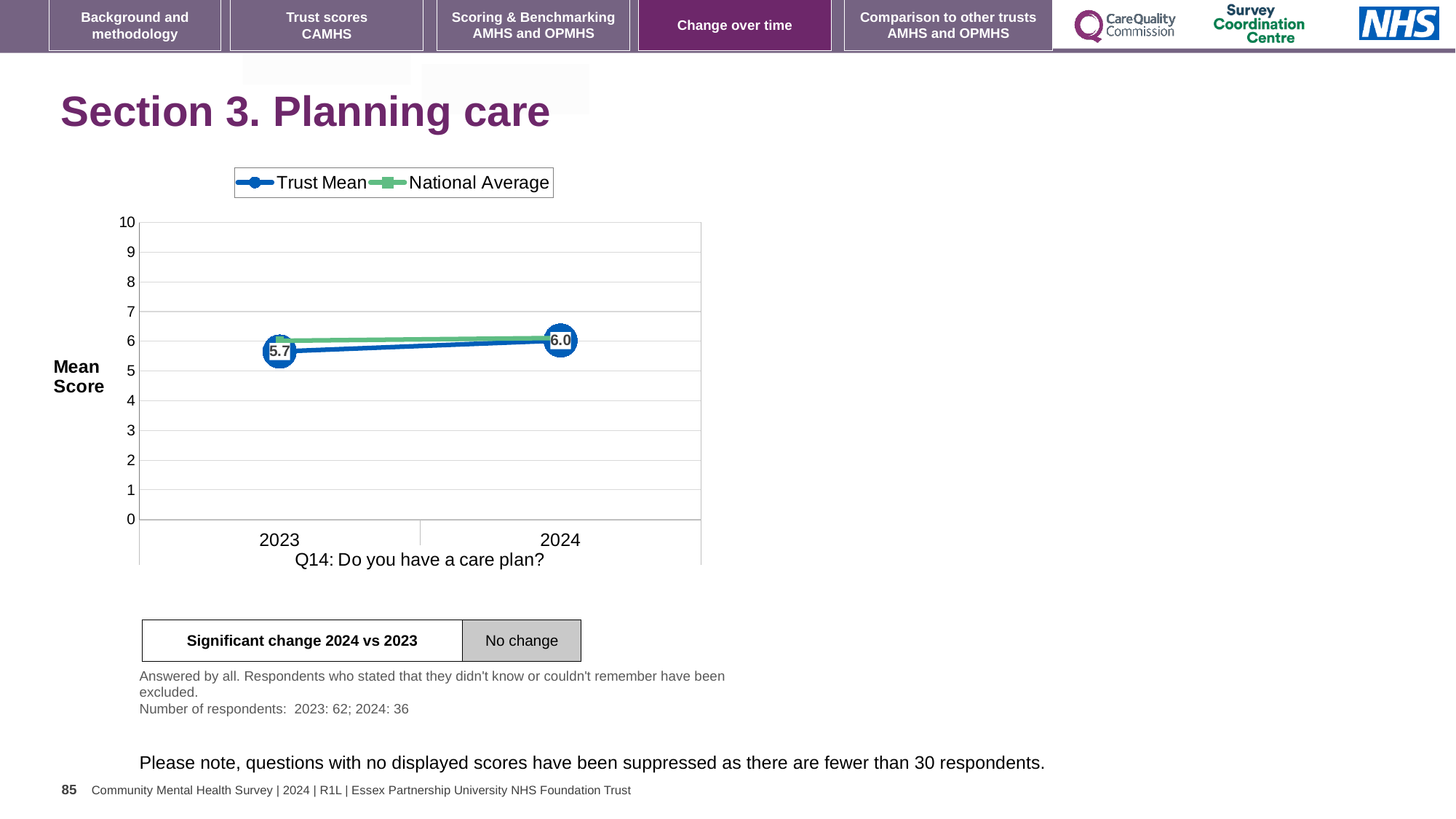
What are the two series named in the chart legend? Trust Mean and National Average What is the Trust Mean value for 2023 in the Q14 chart? 5.7 Is the Trust Mean value for 2023 greater or less than 7? less Is the National Average value for 2023 greater or less than 5? greater What kind of chart is shown on the slide? line chart What is the Trust Mean value for 2024 in the Q14 chart? 6.0 Does the Trust Mean rise or fall from 2023 to 2024? rise How many series does the chart legend list? 2 By how much did the Trust Mean change from 2023 to 2024? 0.3 What survey question is the chart about, as labelled under the x axis? Q14: Do you have a care plan? Which year has the higher Trust Mean, 2023 or 2024? 2024 How many years are plotted on the x axis of the chart? 2